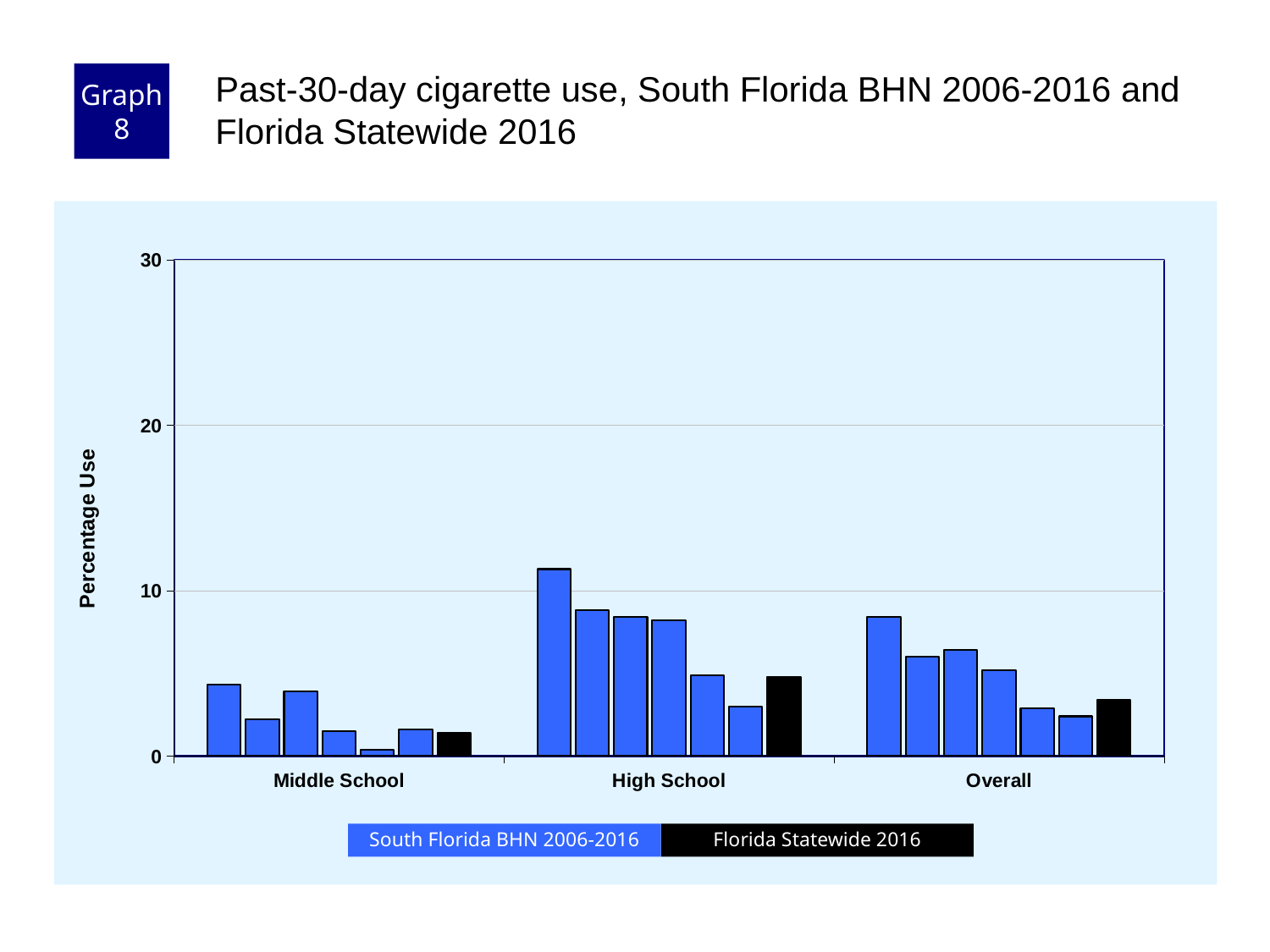
What is the label on the y axis? Percentage Use Is the tallest bar in the Middle School group greater or less than 10? less Within the High School group, do the South Florida BHN 2006-2016 bars rise or fall from left to right? fall Is the Florida Statewide 2016 value for High School greater or less than 10? less Is the tallest South Florida BHN bar in the High School group greater or less than 10? greater Which category has the lowest bars overall? Middle School How many categories are shown on the x axis? 3 Which colour represents Florida Statewide 2016 in the legend? black Is the Florida Statewide 2016 value for High School larger or smaller than the Florida Statewide 2016 value for Middle School? larger How many series does the legend list? 2 What kind of chart is shown on the slide? bar chart Which category has the tallest bar overall? High School